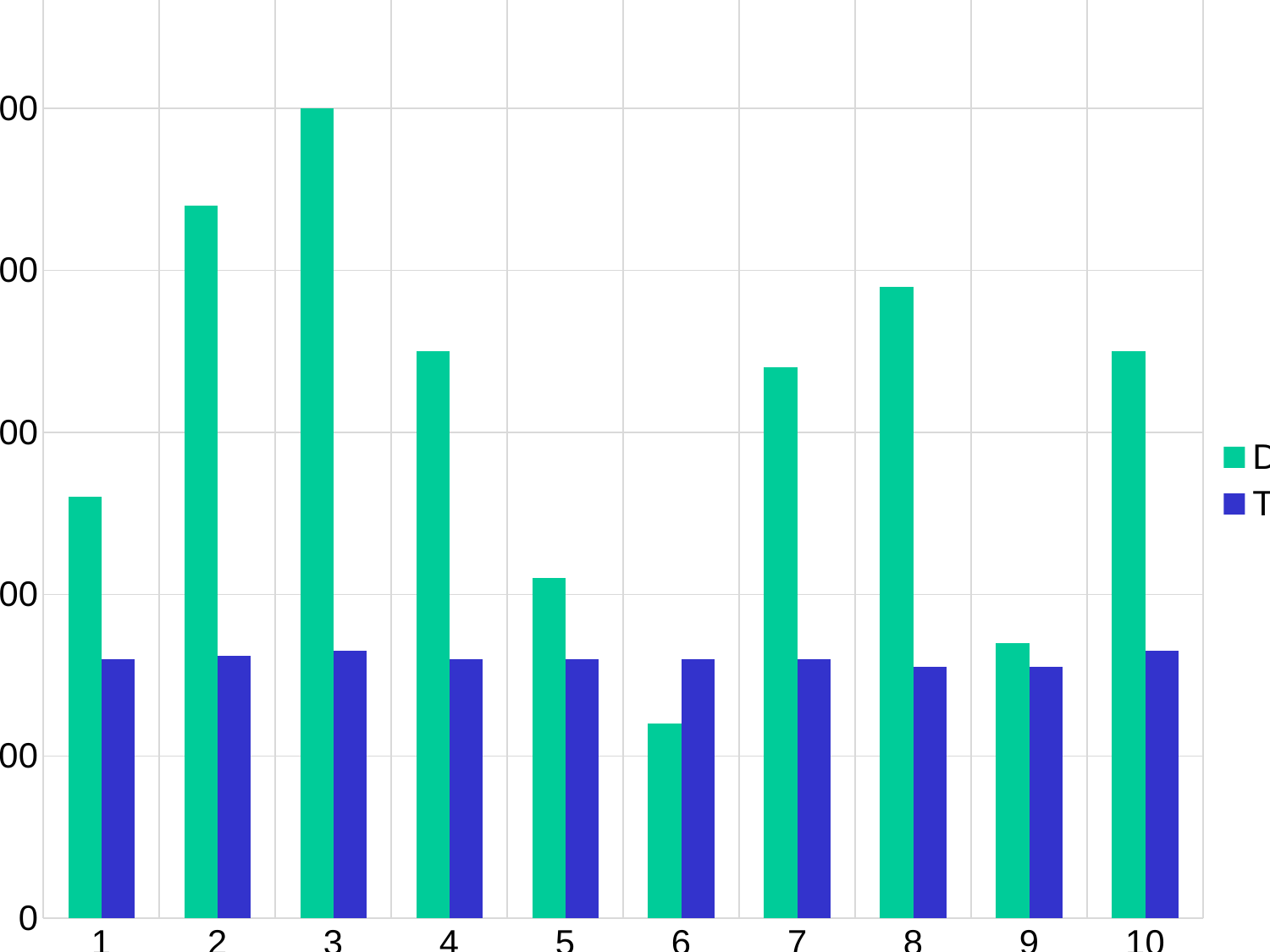
At category 6, which bar is taller, the green one or the blue one? blue Is the green bar for category 2 taller or shorter than the green bar for category 4? taller At category 3, which bar is taller, the green one or the blue one? green Which series has the more uniform bar heights across the categories, the green one or the blue one? blue Which category has the highest green bar? 3 What kind of chart is shown on the slide? bar chart How many series does the chart's legend list? 2 How many categories are shown on the x axis of the chart? 10 Which category has the lowest green bar? 6 What colour are the bars of the first series listed in the legend? green